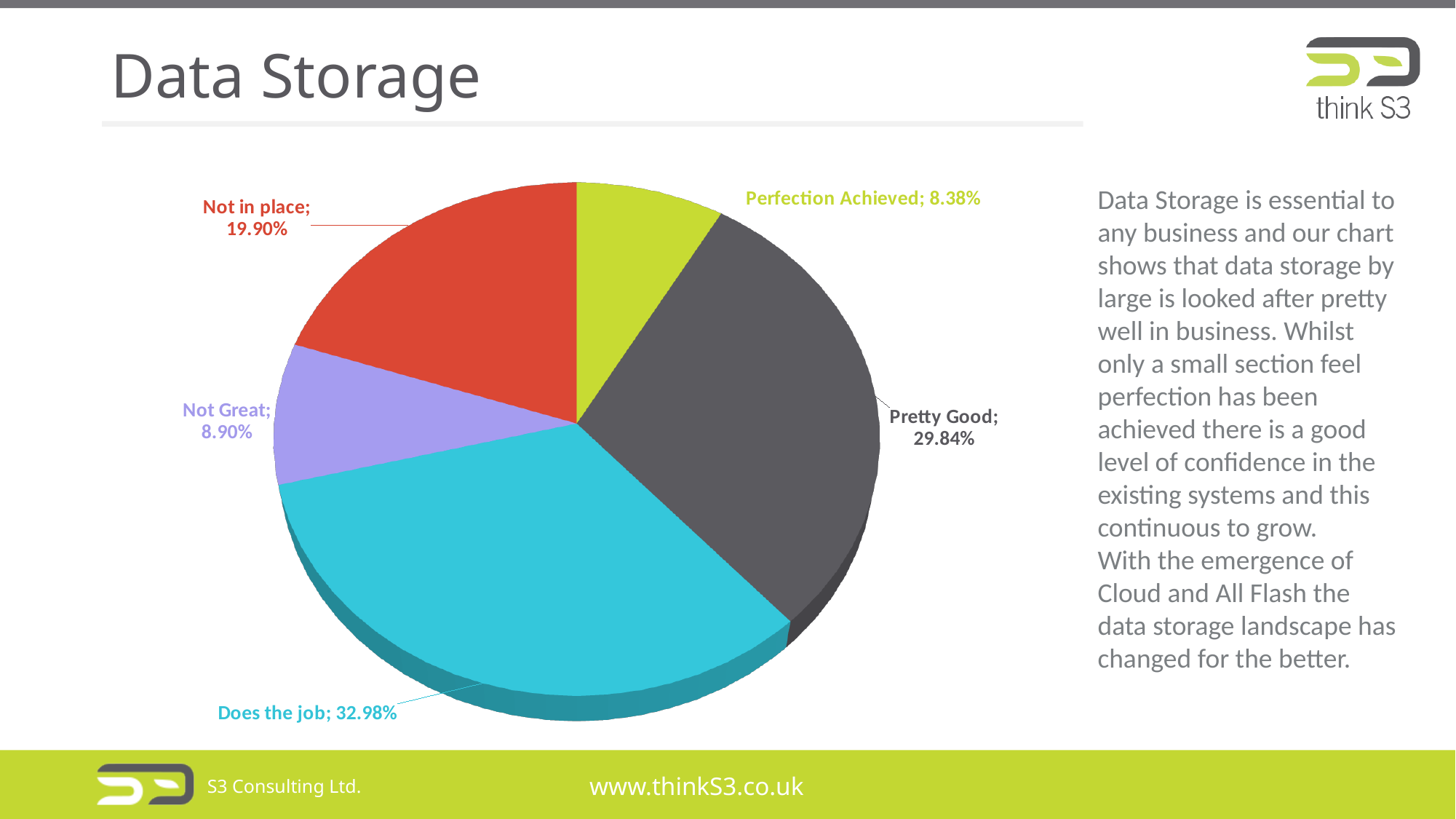
What percentage of the pie is labelled "Not in place"? 19.90% Which slice of the pie is the largest? Does the job How many slices does the pie chart have? 5 What percentage of the pie is labelled "Does the job"? 32.98% What kind of chart is shown on the slide? pie chart Which slice of the pie is the smallest? Perfection Achieved Which is larger, the "Not in place" slice or the "Not Great" slice? Not in place What percentage of the pie is labelled "Perfection Achieved"? 8.38% What is the difference in percentage points between "Does the job" and "Pretty Good"? 3.14 What percentage of the pie is labelled "Pretty Good"? 29.84% What percentage of the pie is labelled "Not Great"? 8.90% What colour is the "Does the job" slice? cyan